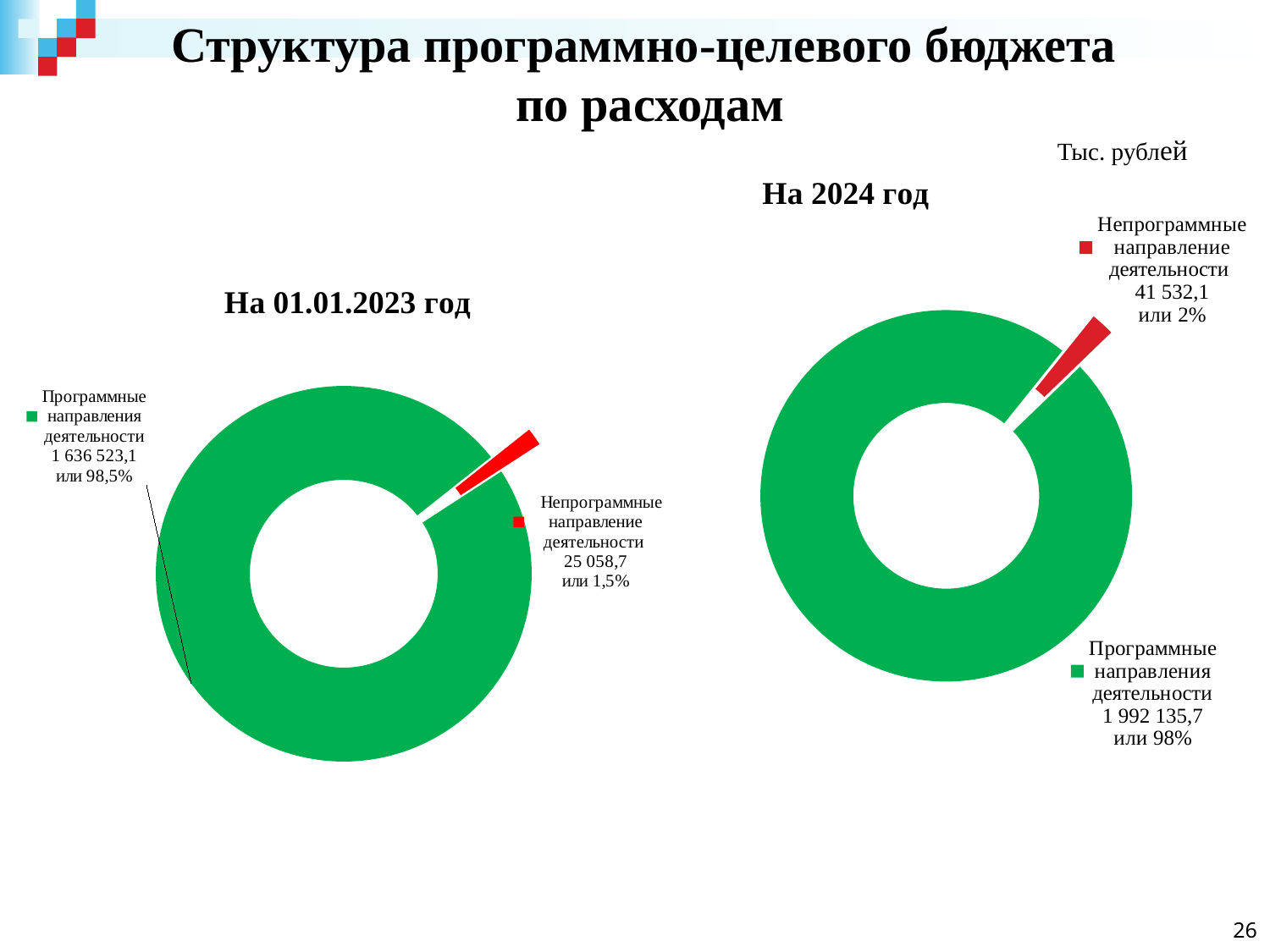
In the chart titled "На 01.01.2023 год", what is the value for "Непрограммные направление деятельности"? 25 058,7 What type of chart is used on the left side of the slide ("На 01.01.2023 год")? Doughnut (pie) chart In the chart titled "На 2024 год", what share of the total does "Программные направления деятельности" represent? 98% In the chart titled "На 2024 год", which category is the largest? Программные направления деятельности How many categories are shown in the chart titled "На 2024 год"? 2 In the chart titled "На 01.01.2023 год", which category is the smallest? Непрограммные направление деятельности In the chart titled "На 2024 год", what is the value for "Непрограммные направление деятельности"? 41 532,1 What colour is the "Непрограммные направление деятельности" slice in the chart titled "На 2024 год"? Red In the chart titled "На 2024 год", what is the value for "Программные направления деятельности"? 1 992 135,7 Which is larger: "Непрограммные направление деятельности" in the chart "На 01.01.2023 год" or in the chart "На 2024 год"? На 2024 год In the chart titled "На 01.01.2023 год", what share of the total does "Непрограммные направление деятельности" represent? 1,5% In the chart titled "На 01.01.2023 год", what is the value for "Программные направления деятельности"? 1 636 523,1